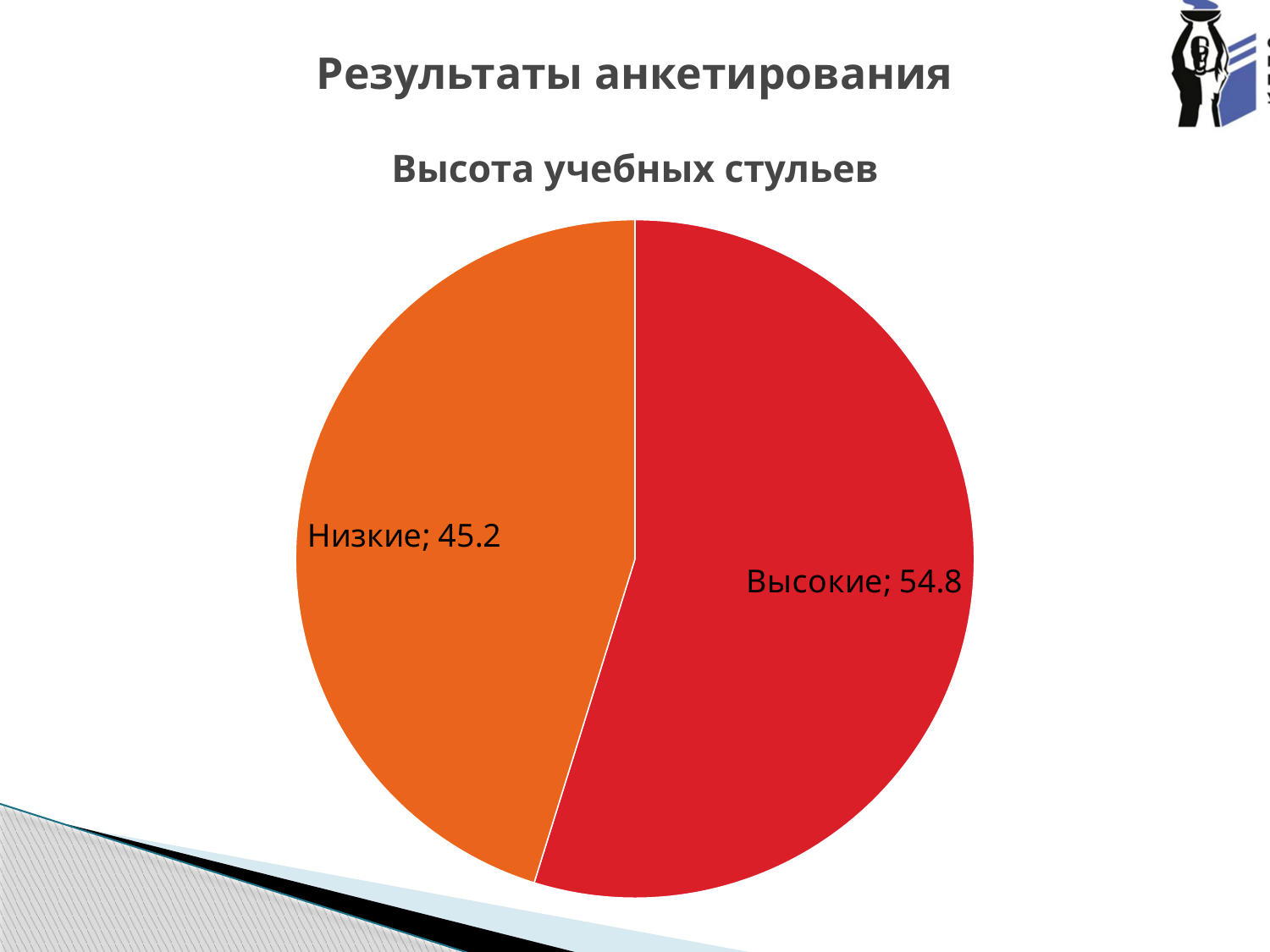
What is the value for Высокие? 54.8 How many slices does the pie chart have? 2 Which category has the largest slice? Высокие Which category has the smallest slice? Низкие What is the difference between the values for Высокие and Низкие? 9.6 Which is larger, the value for Высокие or the value for Низкие? Высокие What colour is the Низкие slice? orange What is the value for Низкие? 45.2 What type of chart is shown on the slide? pie chart What is the total of the two slice values? 100 What is the title of the chart? Высота учебных стульев